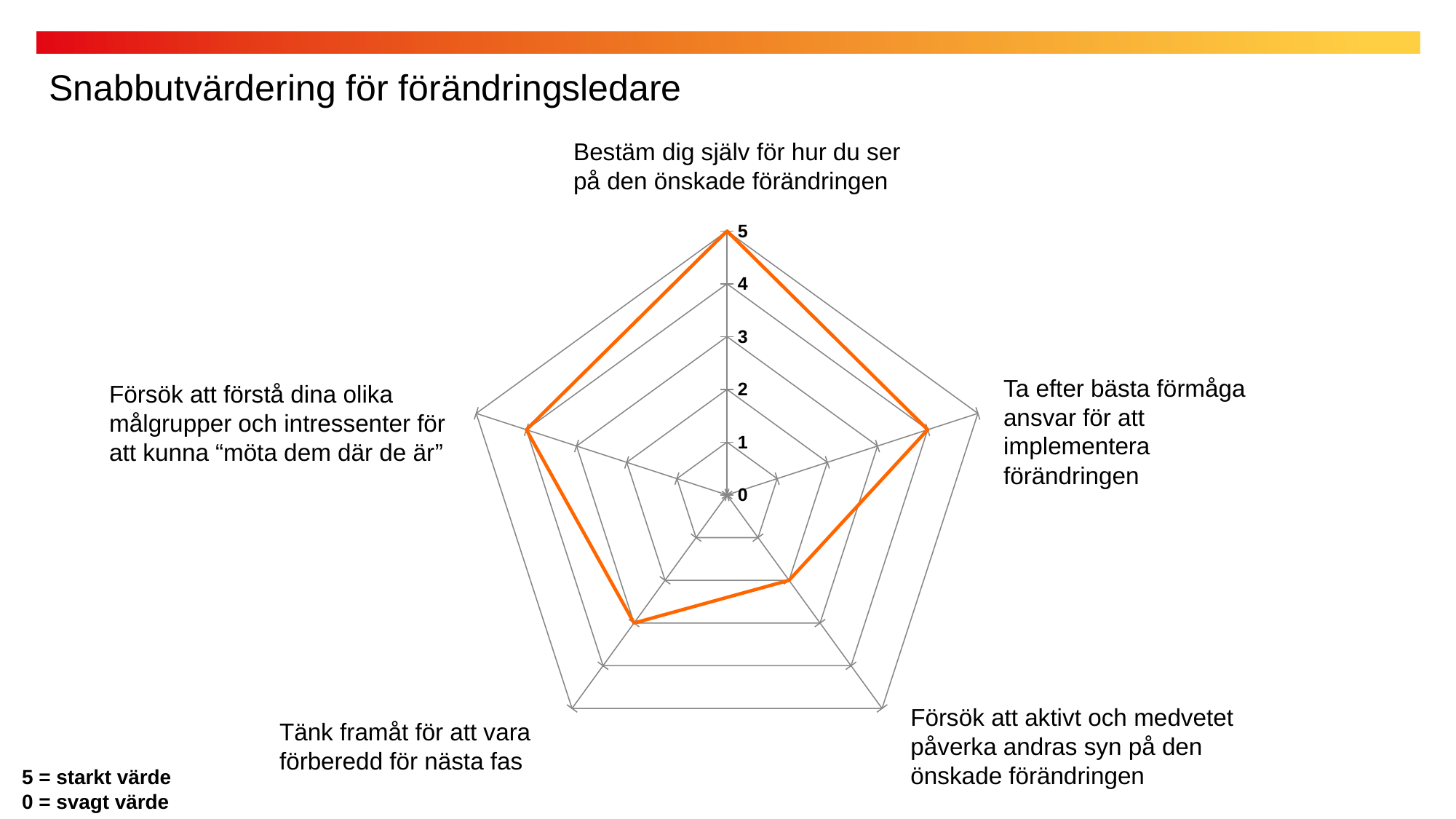
What is the value for "Försök att aktivt och medvetet påverka andras syn på den önskade förändringen"? 2 How many categories (axes) does the radar chart have? 5 What is the maximum value on the chart's scale? 5 What is the value for "Försök att förstå dina olika målgrupper och intressenter för att kunna 'möta dem där de är'"? 4 Which category has the highest value? Bestäm dig själv för hur du ser på den önskade förändringen What is the value for "Tänk framåt för att vara förberedd för nästa fas"? 3 What is the value for "Ta efter bästa förmåga ansvar för att implementera förändringen"? 4 Which is larger: the value for "Tänk framåt för att vara förberedd för nästa fas" or the value for "Ta efter bästa förmåga ansvar för att implementera förändringen"? Ta efter bästa förmåga ansvar för att implementera förändringen What kind of chart is shown on the slide? radar chart Which category has the lowest value? Försök att aktivt och medvetet påverka andras syn på den önskade förändringen What is the value for "Bestäm dig själv för hur du ser på den önskade förändringen"? 5 What is the difference between the value for "Bestäm dig själv för hur du ser på den önskade förändringen" and the value for "Försök att aktivt och medvetet påverka andras syn på den önskade förändringen"? 3